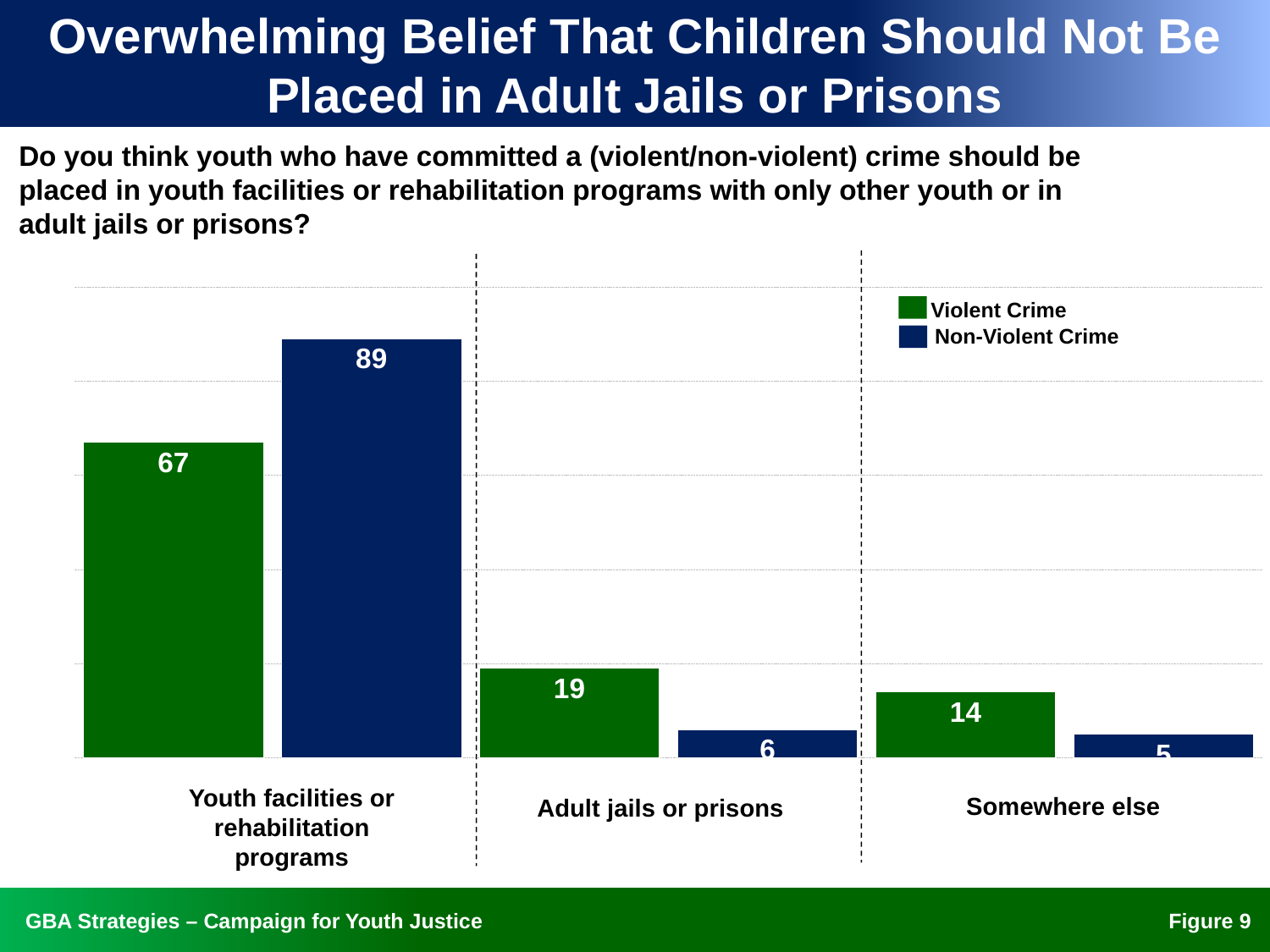
Which colour represents the Violent Crime series? Green What is the value for Non-Violent Crime in the Somewhere else category? 5 What is the value for Non-Violent Crime in the Youth facilities or rehabilitation programs category? 89 What is the value for Violent Crime in the Youth facilities or rehabilitation programs category? 67 Which is larger for Adult jails or prisons: the Violent Crime value or the Non-Violent Crime value? Violent Crime Which category has the highest value for Non-Violent Crime? Youth facilities or rehabilitation programs How many categories are shown on the x axis? 3 Which category has the lowest value for Violent Crime? Somewhere else What kind of chart is shown on the slide? Bar chart How many series does the legend list? 2 What is the value for Violent Crime in the Adult jails or prisons category? 19 What is the difference between the Non-Violent Crime and Violent Crime values for Youth facilities or rehabilitation programs? 22